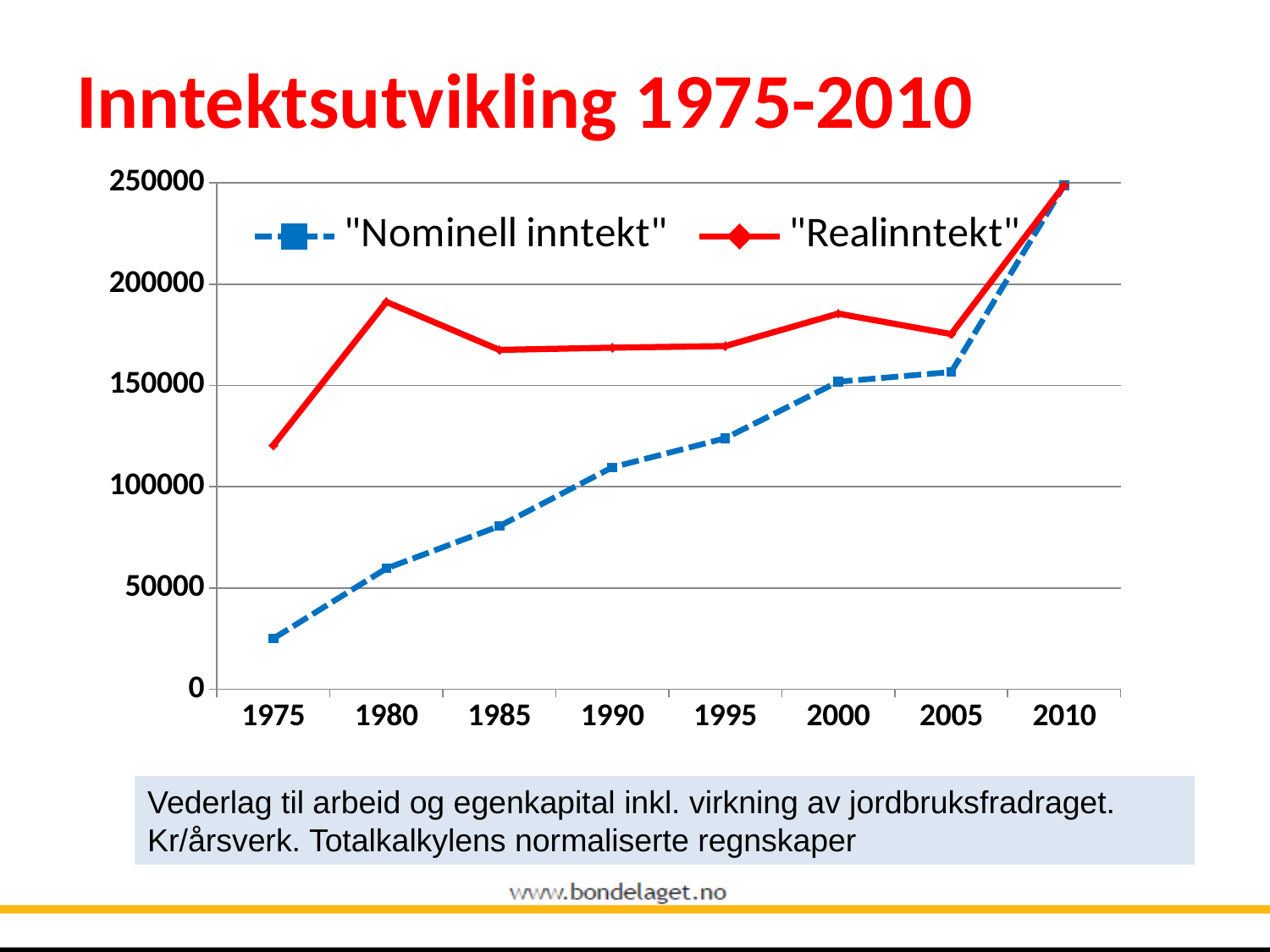
Is the value for "Nominell inntekt" in 1975 greater or less than 50000? less What kind of chart is shown on the slide? Line chart What is the title of the chart? Inntektsutvikling 1975-2010 How many years are plotted along the x axis? 8 Is the value for "Nominell inntekt" in 1990 greater or less than 100000? greater In which year is "Realinntekt" highest? 2010 Which series is drawn with a dashed blue line? "Nominell inntekt" In 1980, which series has the larger value, "Nominell inntekt" or "Realinntekt"? "Realinntekt" Is the value for "Realinntekt" in 1980 greater or less than 200000? less In which year is "Nominell inntekt" lowest? 1975 How many series does the legend list? 2